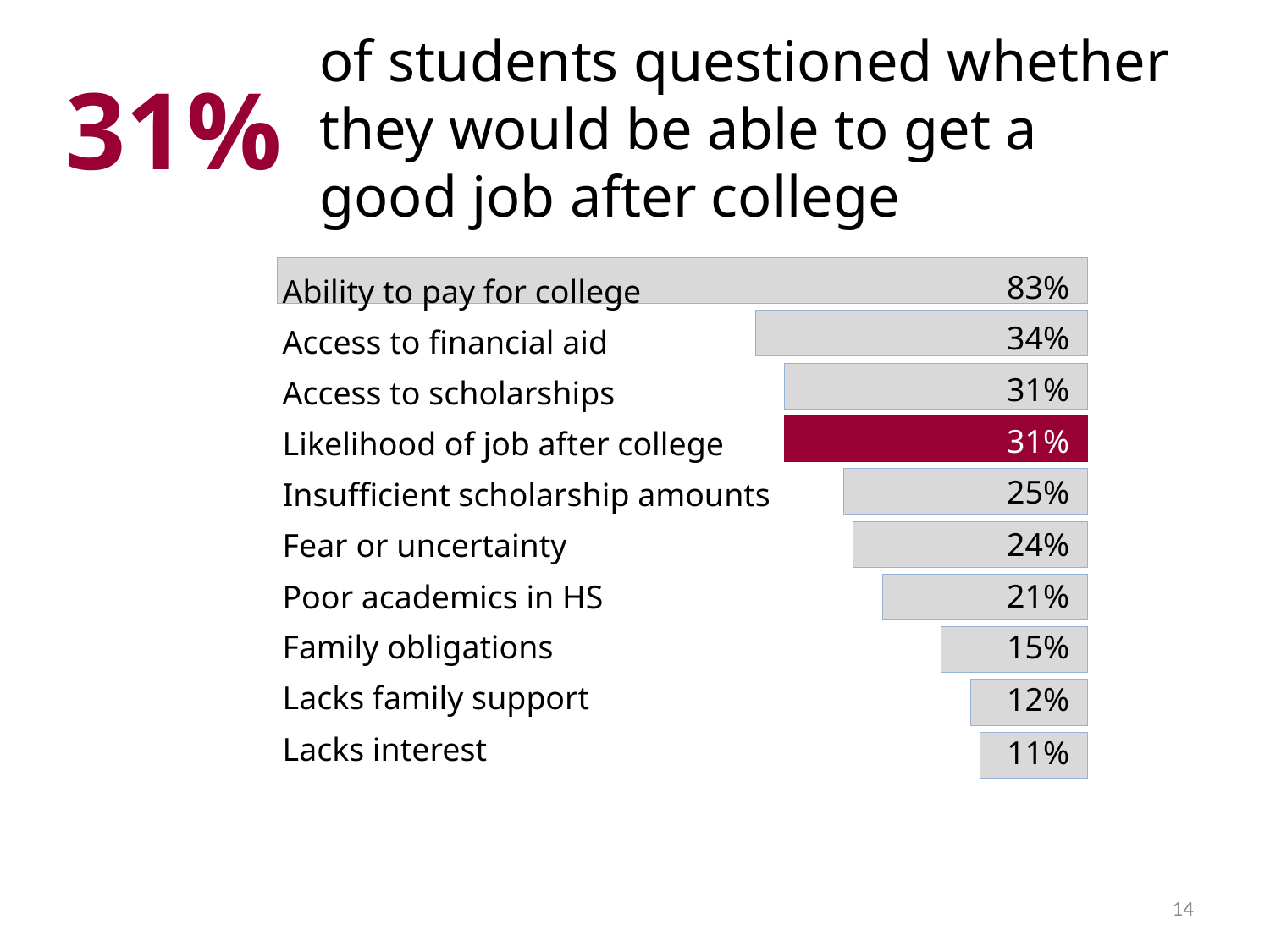
Which bar is highlighted in a different colour from the others? Likelihood of job after college What is the difference between Ability to pay for college and Access to financial aid? 49% What kind of chart is shown on the slide? Bar chart Which category has the highest value? Ability to pay for college How many categories are shown in the chart? 10 Which is larger, Poor academics in HS or Family obligations? Poor academics in HS What is the value for Fear or uncertainty? 24% What is the value for Access to financial aid? 34% Which category has the lowest value? Lacks interest What is the value for Ability to pay for college? 83% What is the difference between Insufficient scholarship amounts and Family obligations? 10% What is the value for Lacks family support? 12%